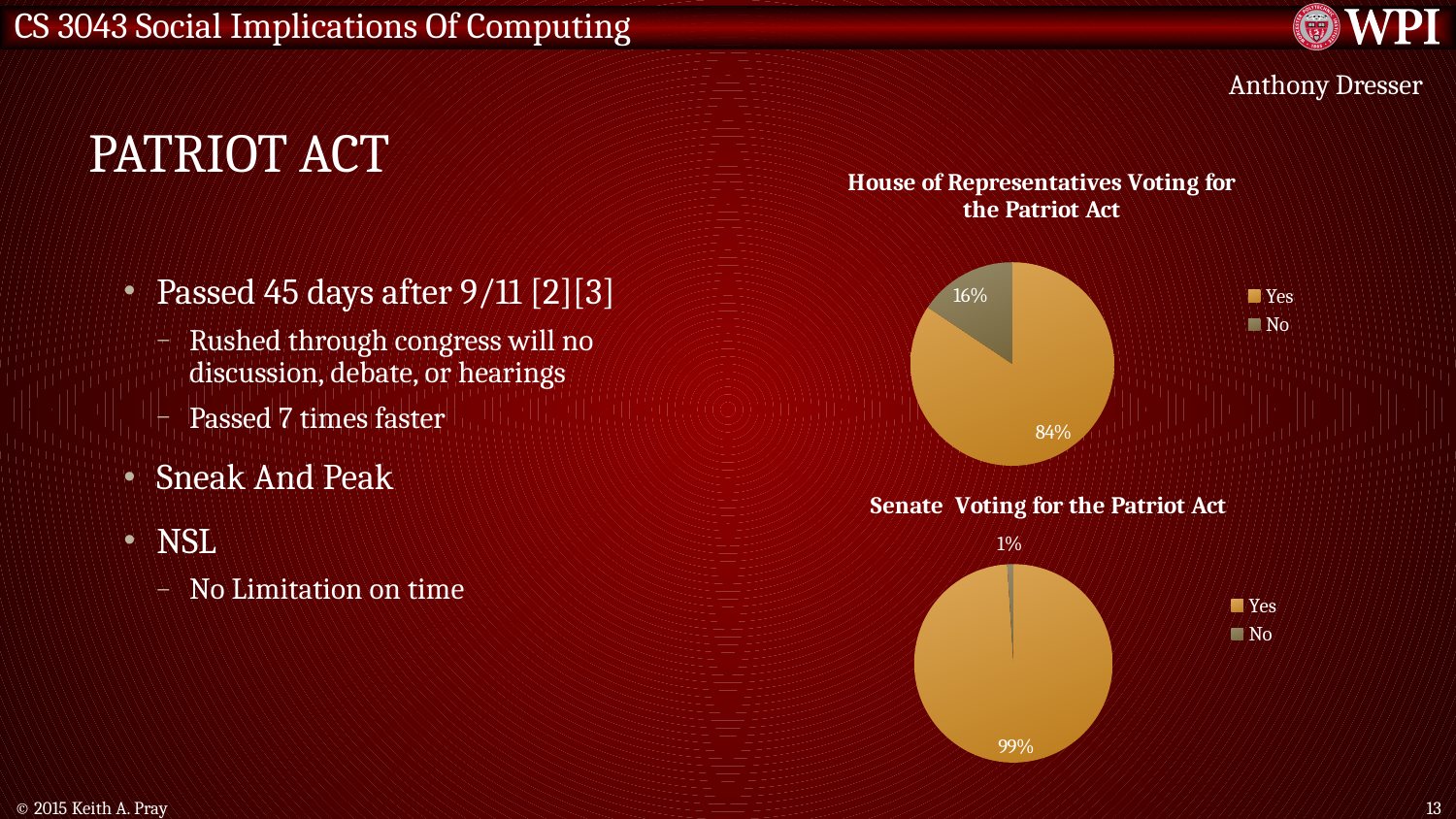
In the 'House of Representatives Voting for the Patriot Act' chart, what share of the pie is 'Yes'? 84% In the 'House of Representatives Voting for the Patriot Act' chart, what is the difference between the 'Yes' and 'No' shares? 68% What kind of chart is the 'House of Representatives Voting for the Patriot Act' chart? Pie chart In the 'House of Representatives Voting for the Patriot Act' chart, what share of the pie is 'No'? 16% In the 'Senate Voting for the Patriot Act' chart, what share of the pie is 'Yes'? 99% In the 'Senate Voting for the Patriot Act' chart, which category has the smallest slice? No What kind of chart is the 'Senate Voting for the Patriot Act' chart? Pie chart How many categories does the legend of the 'Senate Voting for the Patriot Act' chart list? 2 In the 'House of Representatives Voting for the Patriot Act' chart, which category has the largest slice? Yes In the 'Senate Voting for the Patriot Act' chart, what is the difference between the 'Yes' and 'No' shares? 98% Which chart has the larger 'No' share, the House of Representatives chart or the Senate chart? House of Representatives